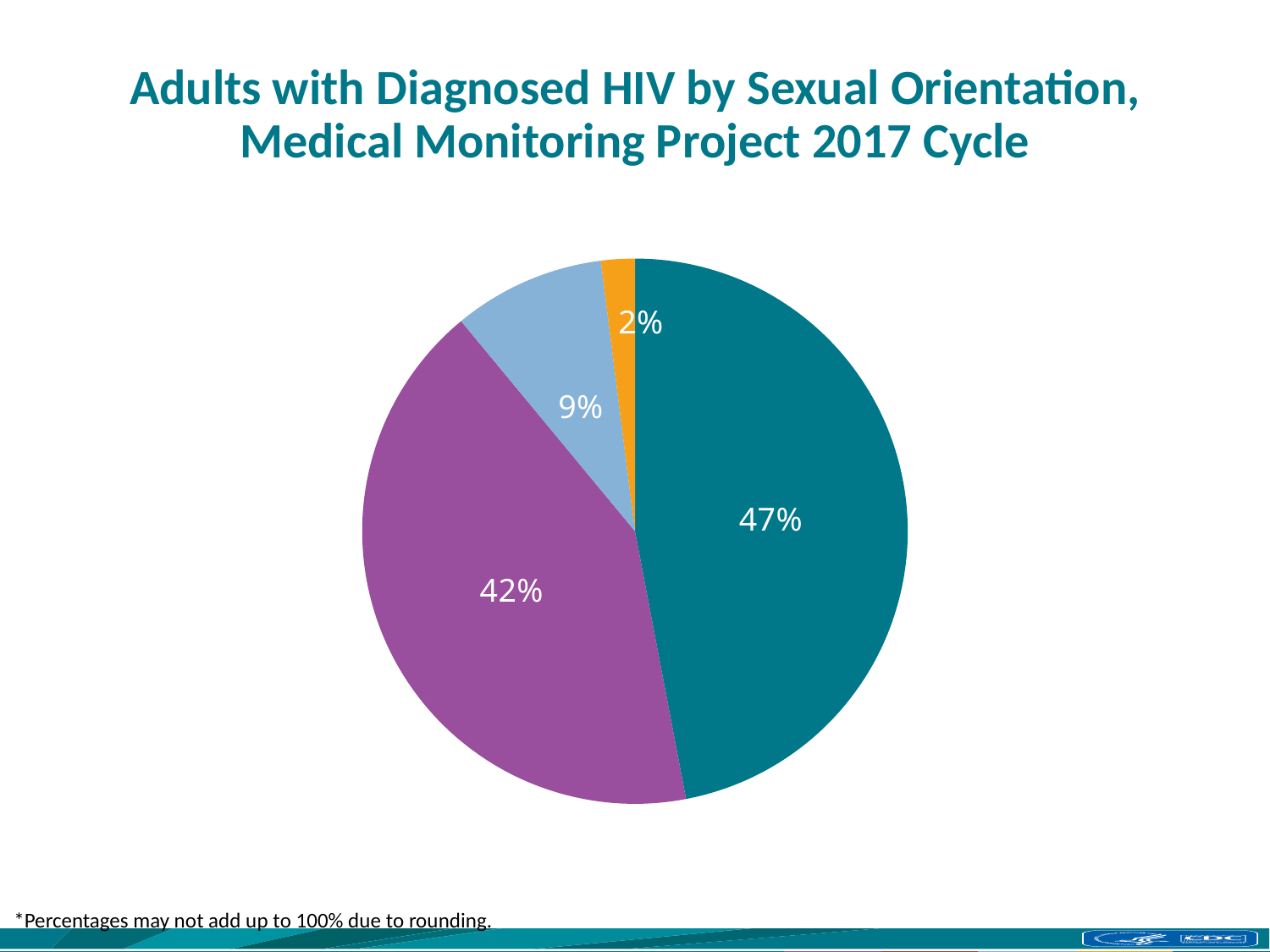
What percentage is shown on the orange slice of the pie? 2% How many slices does the pie chart have? 4 What is the title of the chart? Adults with Diagnosed HIV by Sexual Orientation, Medical Monitoring Project 2017 Cycle What colour is the largest slice of the pie? teal What percentage is shown on the largest slice of the pie? 47% What is the difference in percentage points between the teal slice (47%) and the purple slice (42%)? 5 What percentage is shown on the light blue slice of the pie? 9% What percentage is shown on the purple slice of the pie? 42% What kind of chart is shown on the slide? pie chart What percentage is shown on the teal slice of the pie? 47% What percentage is shown on the smallest slice of the pie? 2% Which slice is larger, the light blue slice or the orange slice? the light blue slice